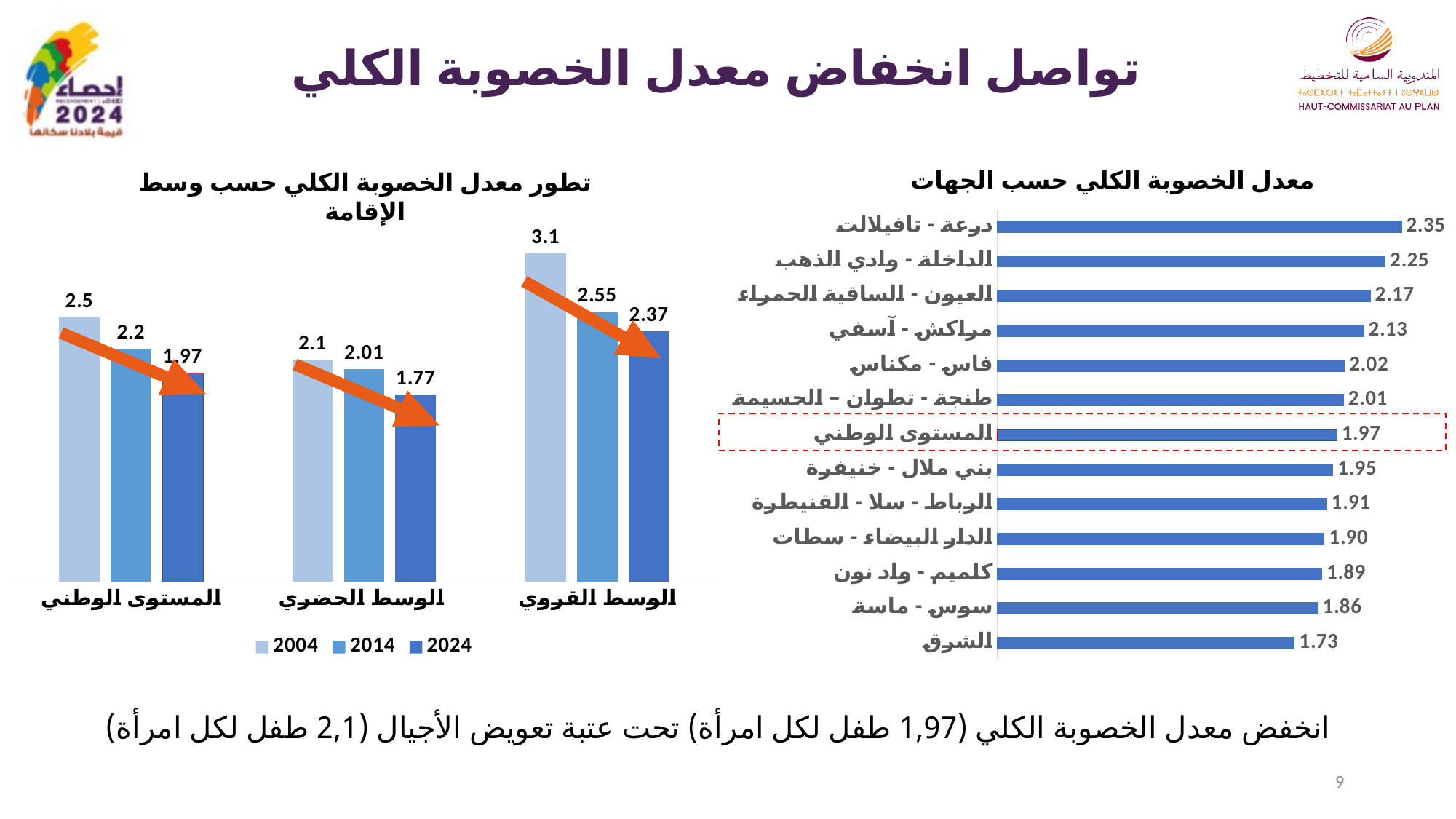
In the chart titled 'معدل الخصوبة الكلي حسب الجهات' (right), which region has the highest value? درعة - تافيلالت In the chart titled 'معدل الخصوبة الكلي حسب الجهات' (right), how many bars are plotted? 13 What type of chart is the one titled 'معدل الخصوبة الكلي حسب الجهات' (right)? bar chart In the chart titled 'تطور معدل الخصوبة الكلي حسب وسط الإقامة' (left), what is the 2024 value for الوسط القروي? 2.37 In the chart titled 'تطور معدل الخصوبة الكلي حسب وسط الإقامة' (left), do the values for المستوى الوطني rise or fall from 2004 to 2024? fall In the chart titled 'معدل الخصوبة الكلي حسب الجهات' (right), which region has the lowest value? الشرق In the chart titled 'معدل الخصوبة الكلي حسب الجهات' (right), what is the value for سوس - ماسة? 1.86 In the chart titled 'تطور معدل الخصوبة الكلي حسب وسط الإقامة' (left), what is the 2004 value for الوسط الحضري? 2.1 In the chart titled 'معدل الخصوبة الكلي حسب الجهات' (right), what is the difference between the values for الداخلة - وادي الذهب and الشرق? 0.52 In the chart titled 'تطور معدل الخصوبة الكلي حسب وسط الإقامة' (left), what is the difference between the 2004 and 2024 values for الوسط القروي? 0.73 In the chart titled 'معدل الخصوبة الكلي حسب الجهات' (right), what is the value for درعة - تافيلالت? 2.35 In the chart titled 'تطور معدل الخصوبة الكلي حسب وسط الإقامة' (left), how many series does the legend list? 3